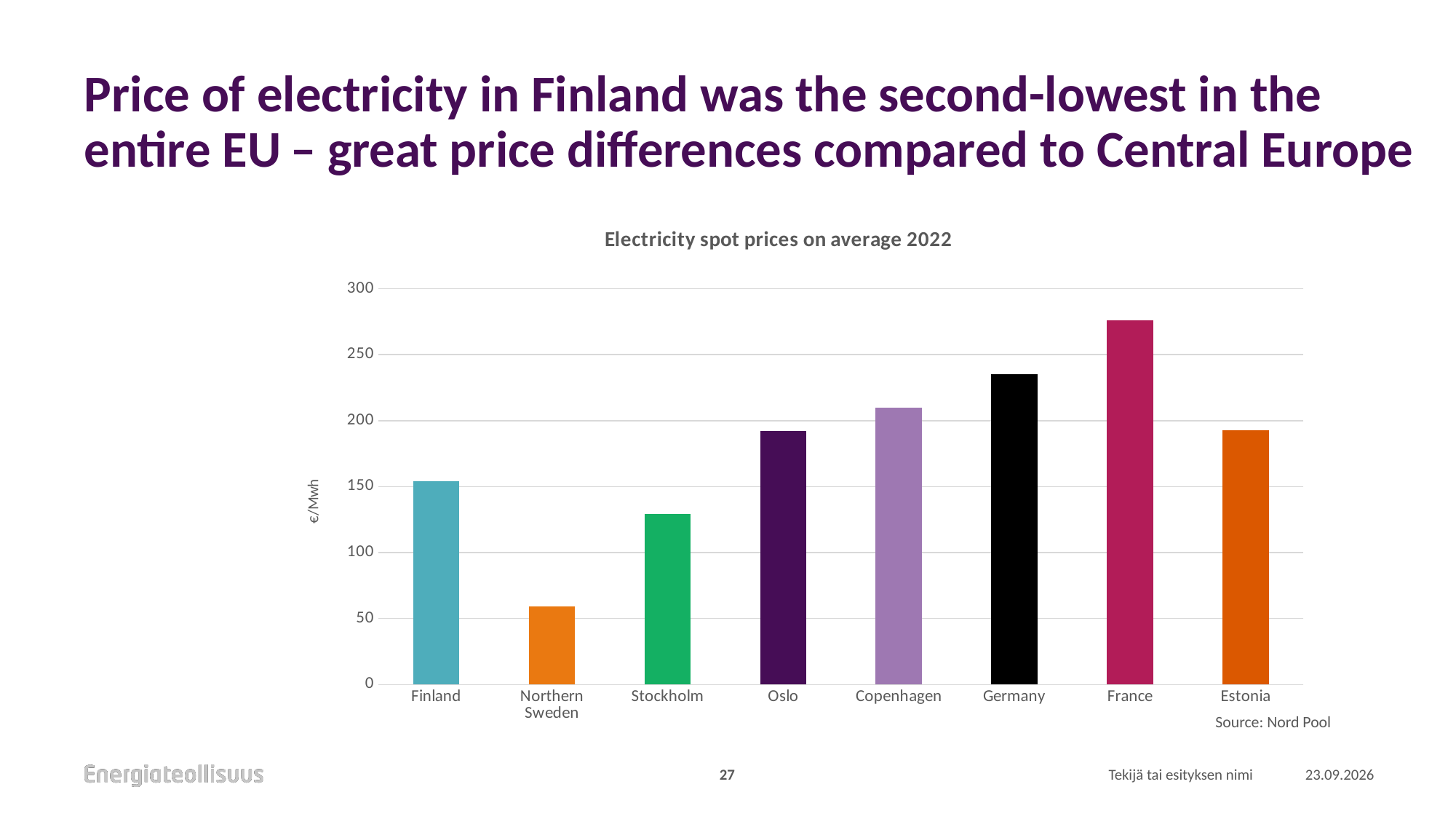
Is the value for France greater or less than 250? greater How many categories are shown on the x axis of the chart? 8 Which category has the lowest electricity spot price in the chart? Northern Sweden Which has the higher value, Finland or Stockholm? Finland Is the value for Copenhagen greater or less than 200? greater Which category has the highest electricity spot price in the chart? France Is the value for Stockholm greater or less than 150? less Which has the higher value, Germany or Copenhagen? Germany What kind of chart is shown on the slide? bar chart What is the title of the chart? Electricity spot prices on average 2022